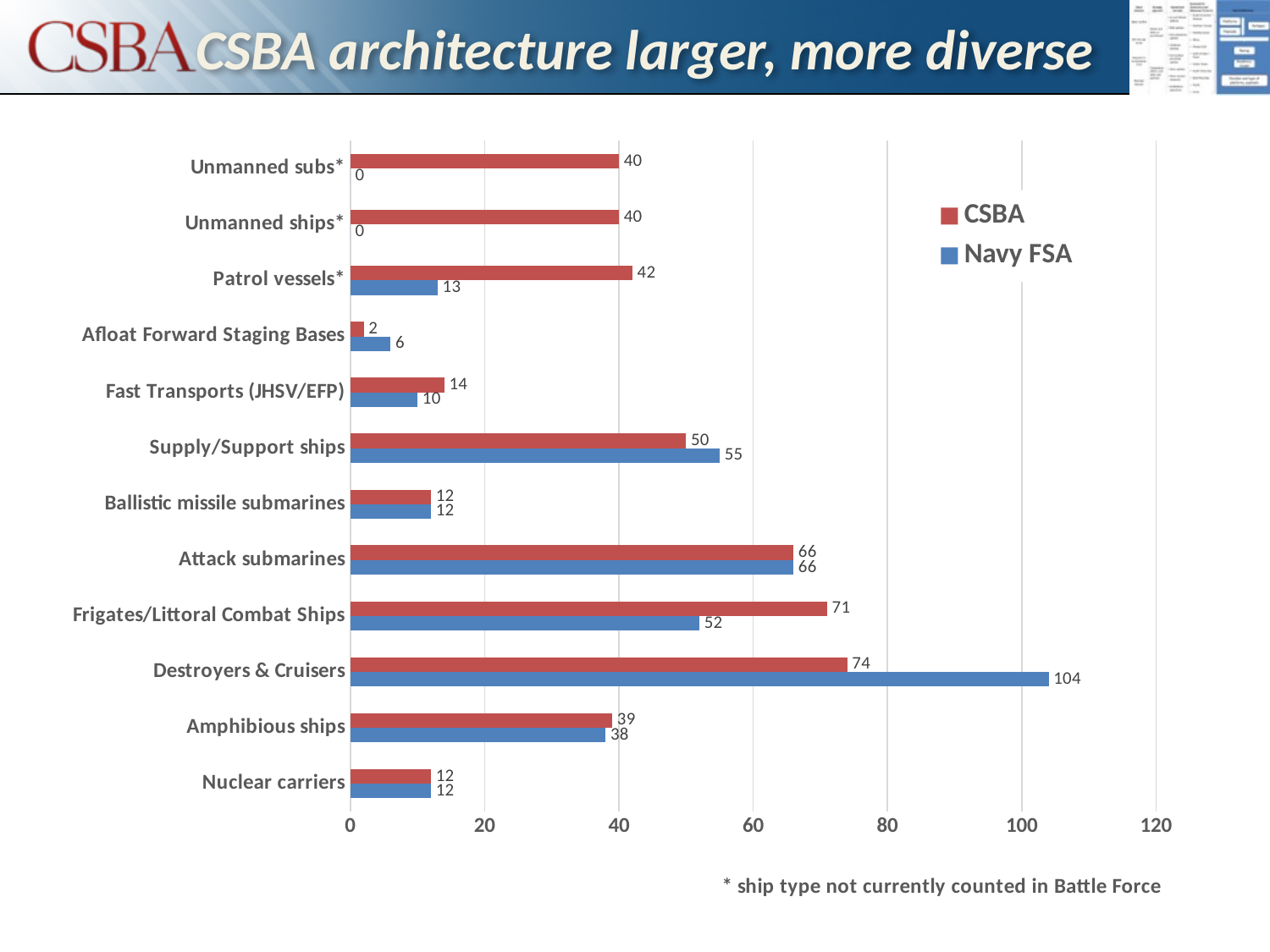
What kind of chart is shown on the slide? Bar chart How many series does the legend list? 2 What is the Navy FSA value for Destroyers & Cruisers? 104 Which is larger for Supply/Support ships, the CSBA value or the Navy FSA value? Navy FSA What does the asterisk on some category labels indicate, according to the note on the slide? Ship type not currently counted in Battle Force What is the CSBA value for Destroyers & Cruisers? 74 What is the Navy FSA value for Patrol vessels*? 13 Is the CSBA value for Frigates/Littoral Combat Ships greater or less than 60? greater What is the difference between the Navy FSA and CSBA values for Destroyers & Cruisers? 30 Which category has the lowest CSBA value? Afloat Forward Staging Bases How many ship categories are shown on the chart? 12 Which category has the highest Navy FSA value? Destroyers & Cruisers